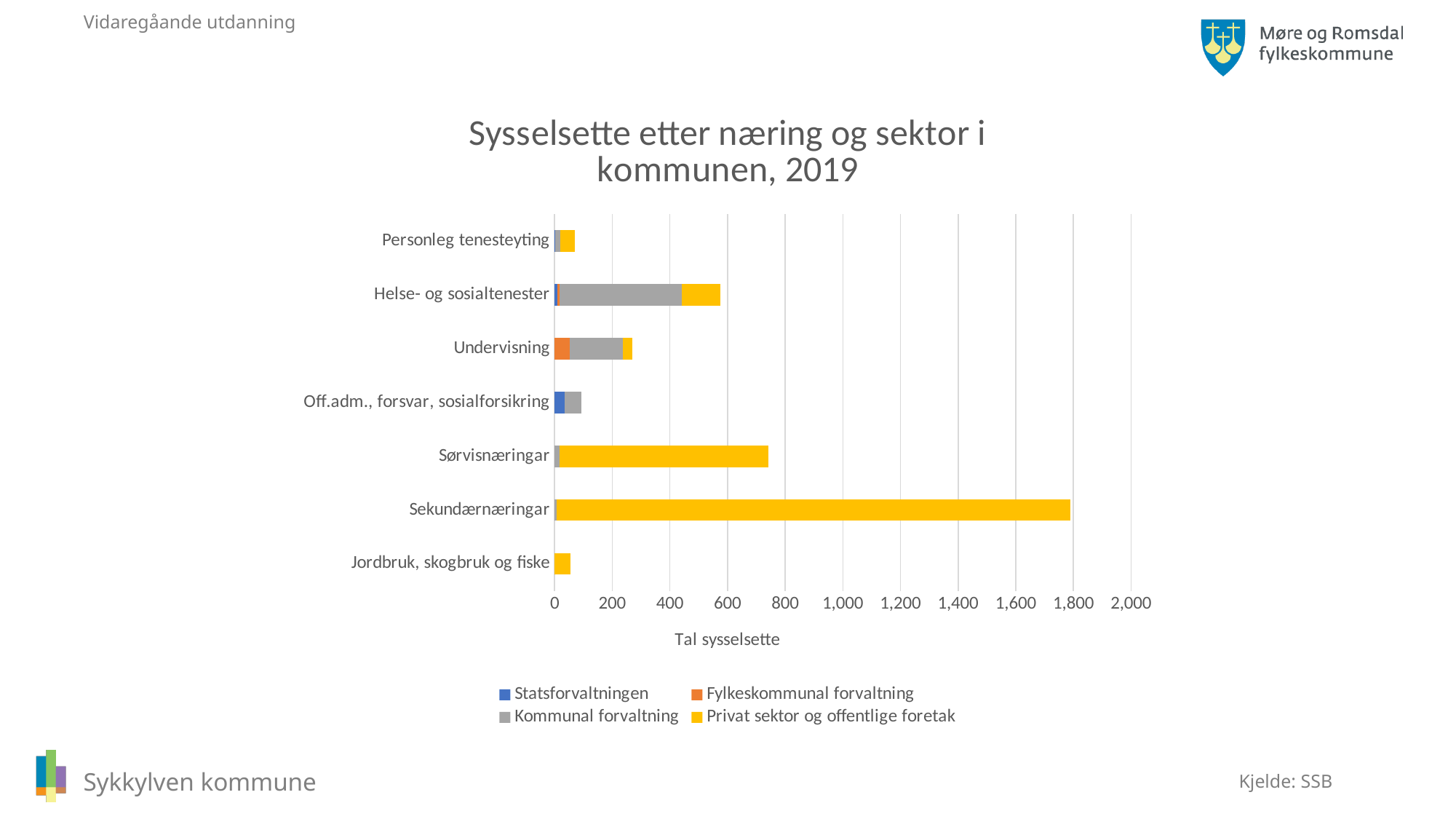
How many series does the legend list? 4 What is the title of the x axis? Tal sysselsette Which has a larger total bar, Sørvisnæringar or Helse- og sosialtenester? Sørvisnæringar Is the total value for Helse- og sosialtenester greater or less than 400? greater Is the total value for Off.adm., forsvar, sosialforsikring greater or less than 200? less What kind of chart is shown on the slide? Stacked bar chart In which category is the Kommunal forvaltning segment the largest? Helse- og sosialtenester Is the total value for Sekundærnæringar greater or less than 1,600? greater How many industry categories are shown on the y axis of the chart? 7 Which category has the longest total bar? Sekundærnæringar